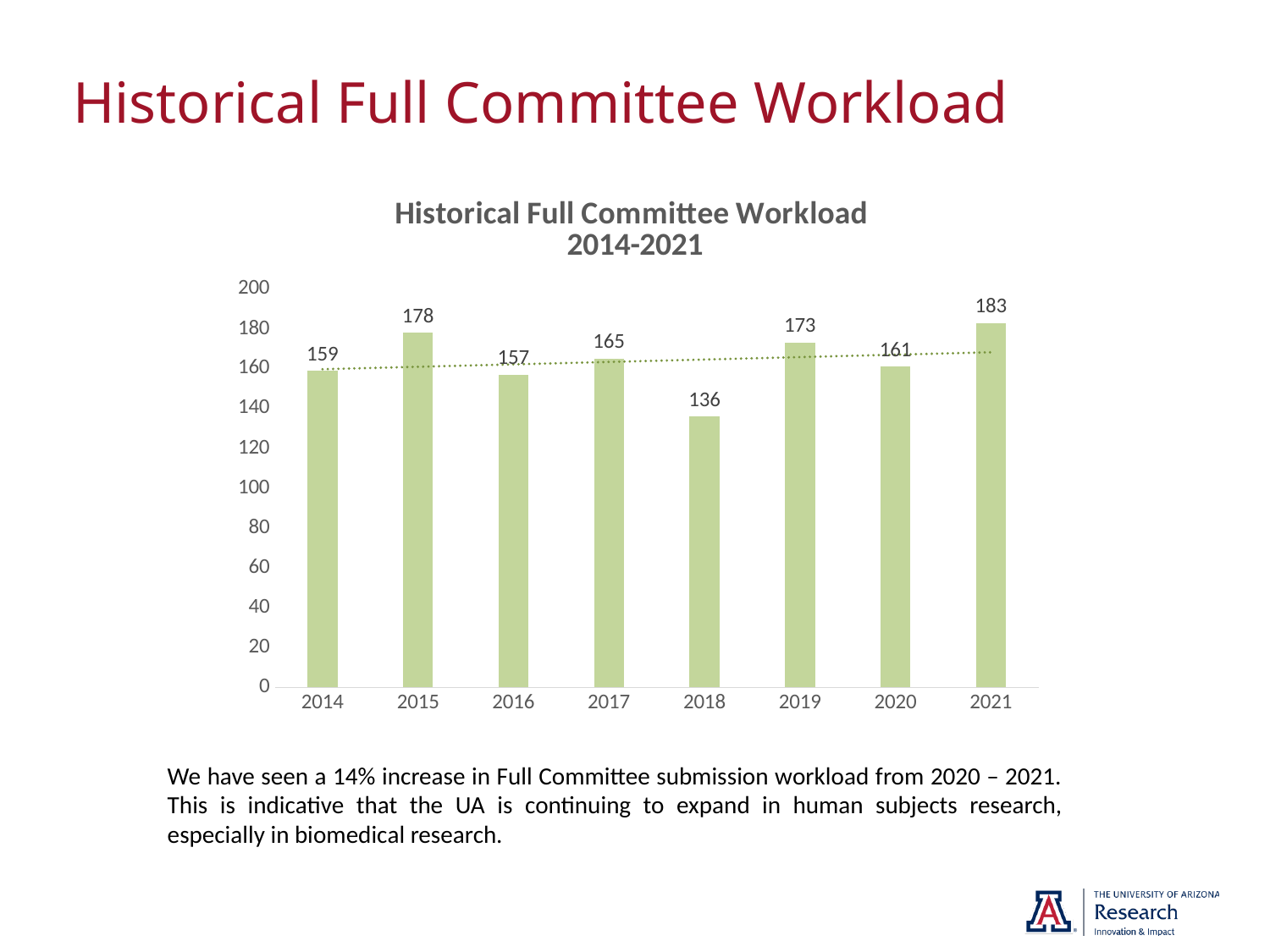
What is the difference between the workload in 2021 and the workload in 2020? 22 Is the value for 2018 greater or less than 140? less What is the Full Committee workload value for 2018? 136 Which year has the lowest Full Committee workload? 2018 What kind of chart is used to show the Historical Full Committee Workload? bar chart What is the Full Committee workload value for 2021? 183 Which year has a larger workload, 2019 or 2016? 2019 What is the difference between the workload in 2015 and the workload in 2018? 42 How many years are shown on the x axis of the chart? 8 What is the title of the chart? Historical Full Committee Workload 2014-2021 What is the Full Committee workload value for 2015? 178 Which year has the highest Full Committee workload? 2021